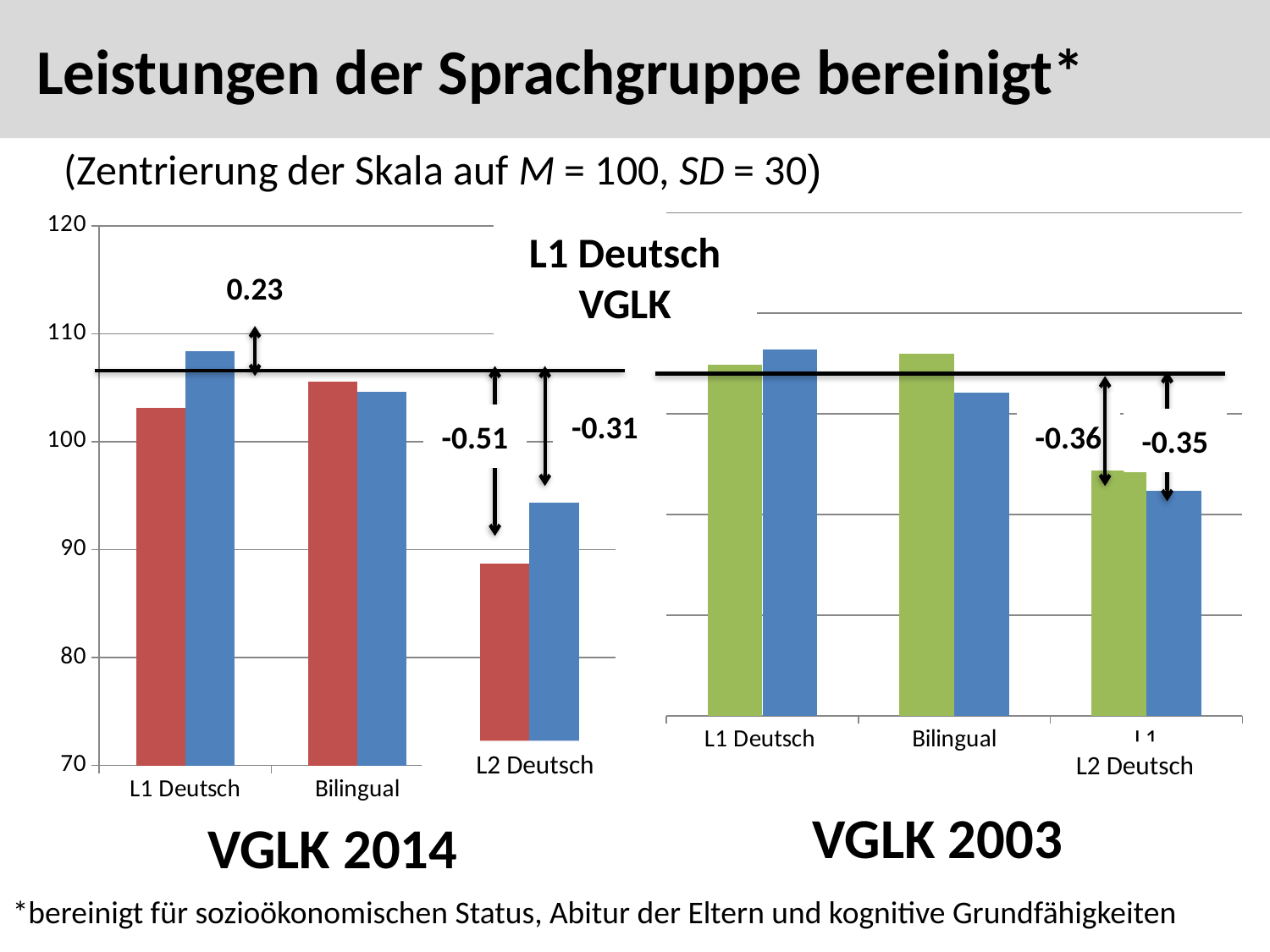
In the VGLK 2014 chart, for L2 Deutsch, is the red bar or the blue bar taller? the blue bar In the VGLK 2014 chart, is the red bar for L1 Deutsch greater or less than 100? greater In the VGLK 2014 chart, how many bars are plotted for each category? 2 How many categories are shown on the x axis of the VGLK 2003 chart? 3 In the VGLK 2014 chart, which bar is the tallest? the blue bar for L1 Deutsch What kind of chart is the VGLK 2014 chart on the left? bar chart In the VGLK 2014 chart, do the blue bars rise or fall from L1 Deutsch to L2 Deutsch? fall In the VGLK 2014 chart, which category has the lowest bars? L2 Deutsch What value is annotated above the L1 Deutsch bars in the VGLK 2014 chart? 0.23 In the VGLK 2014 chart, is the blue bar for L2 Deutsch greater or less than 90? greater In the VGLK 2014 chart, is the red bar for L2 Deutsch greater or less than 90? less How many categories are shown on the x axis of the VGLK 2014 chart? 3